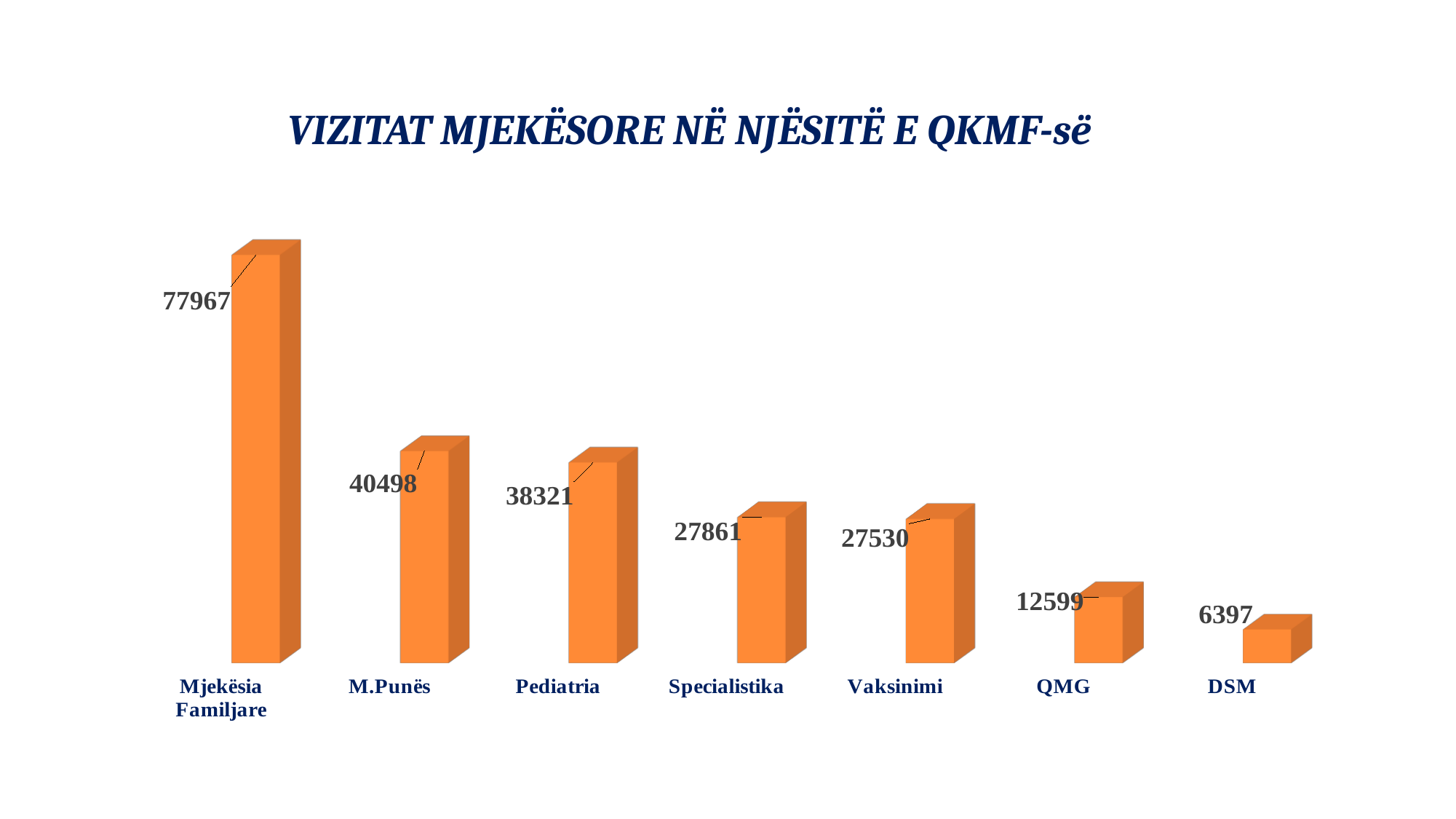
What is the title of the chart? VIZITAT MJEKËSORE NË NJËSITË E QKMF-së How many categories are shown in the chart? 7 What is the value for QMG? 12599 What is the value for Mjekësia Familjare? 77967 Which category has the highest value? Mjekësia Familjare What is the value for Pediatria? 38321 What is the difference between the values for Specialistika and Vaksinimi? 331 Which is larger, the value for QMG or the value for DSM? QMG What is the difference between the values for M.Punës and Pediatria? 2177 Which category has the lowest value? DSM Which is larger, the value for M.Punës or the value for Pediatria? M.Punës What kind of chart is shown on the slide? bar chart